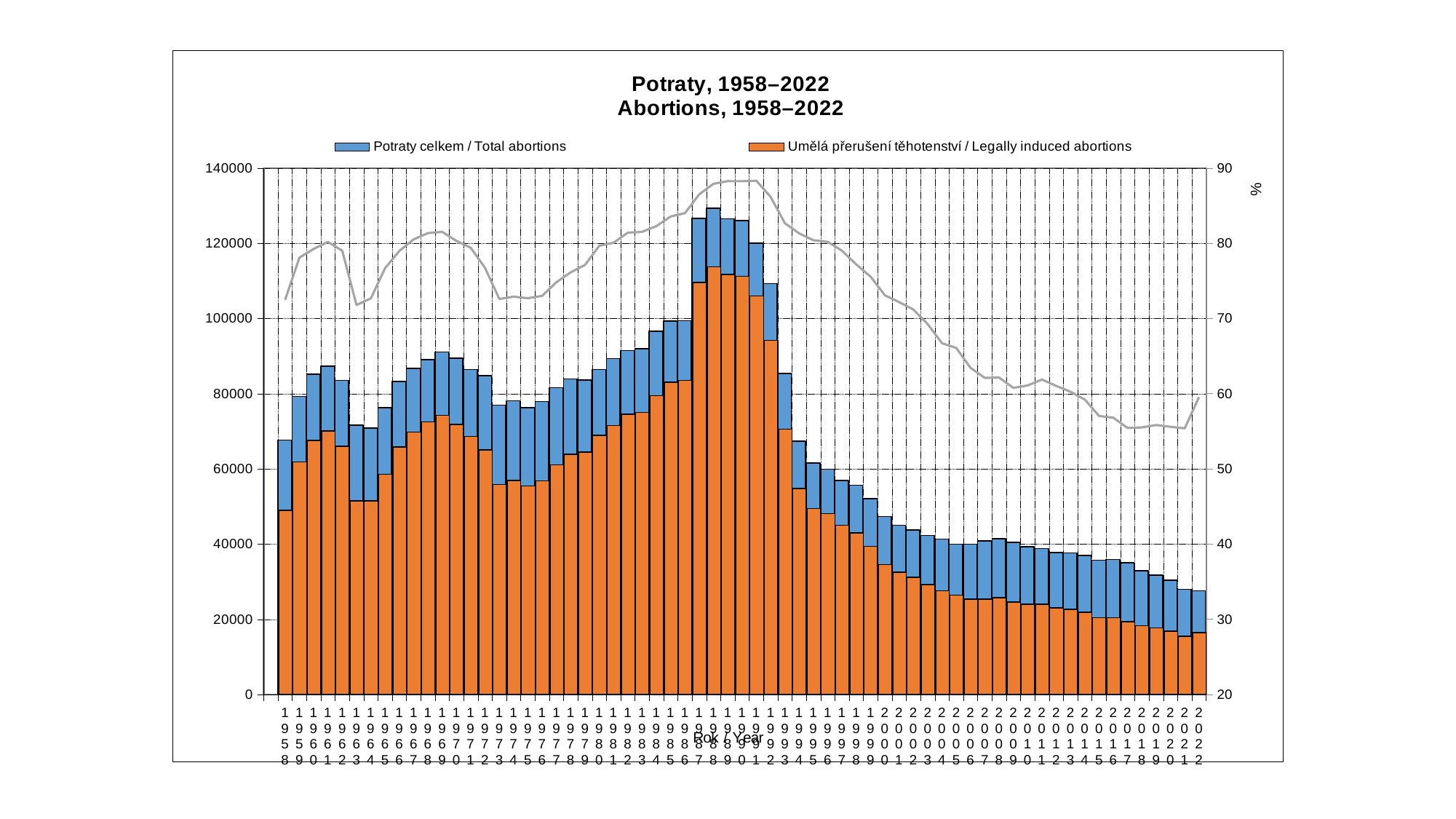
Is the value for Umělá přerušení těhotenství / Legally induced abortions in 1958 greater or less than 60000? less Do the values for Potraty celkem / Total abortions rise or fall from 1988 to 2022? fall In which year is the value for Potraty celkem / Total abortions lowest? 2022 What colour represents Potraty celkem / Total abortions in the chart? blue In which year is the value for Umělá přerušení těhotenství / Legally induced abortions highest? 1988 How many series does the legend list? 2 How many years (categories) are plotted along the x axis? 65 In which year is the value for Potraty celkem / Total abortions highest? 1988 Which is larger, the value for Potraty celkem / Total abortions in 1970 or in 2010? 1970 What kind of chart is shown on the slide? combination bar and line chart Is the value for Potraty celkem / Total abortions in 2022 greater or less than 40000? less Is the value for Potraty celkem / Total abortions in 1988 greater or less than 120000? greater